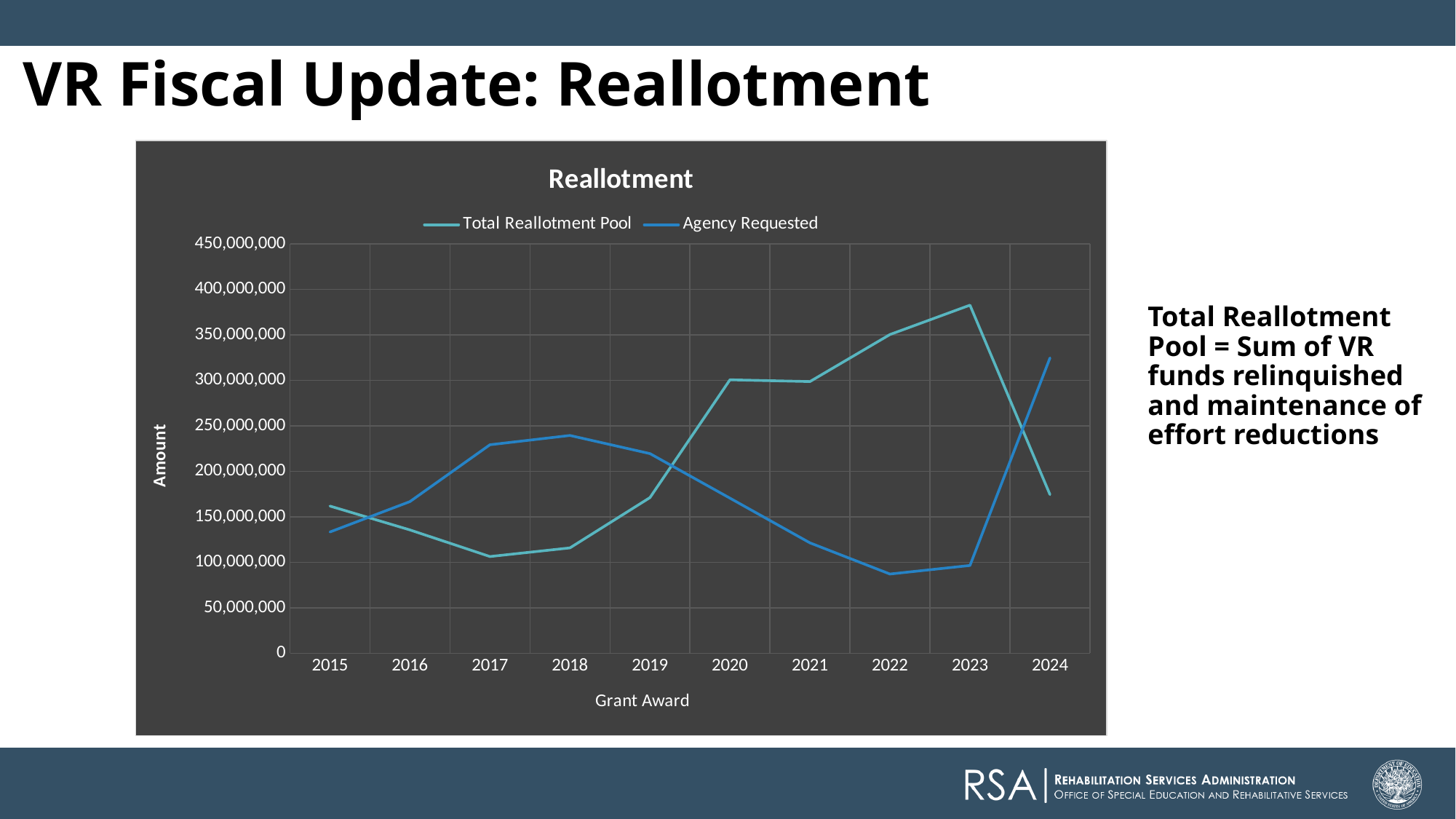
In which grant award year is the Agency Requested amount lowest? 2022 In which grant award year is the Agency Requested amount highest? 2024 Is the Total Reallotment Pool for 2023 greater or less than 350,000,000? greater Is the Agency Requested amount for 2022 greater or less than 100,000,000? less What kind of chart is shown on the slide? Line chart In which grant award year is the Total Reallotment Pool lowest? 2017 In 2020, which series has the larger value, Total Reallotment Pool or Agency Requested? Total Reallotment Pool What is the title of the x axis of the Reallotment chart? Grant Award How many series does the legend of the Reallotment chart list? 2 How many grant award years are plotted along the x axis of the Reallotment chart? 10 In which grant award year is the Total Reallotment Pool highest? 2023 In 2018, which series has the larger value, Total Reallotment Pool or Agency Requested? Agency Requested